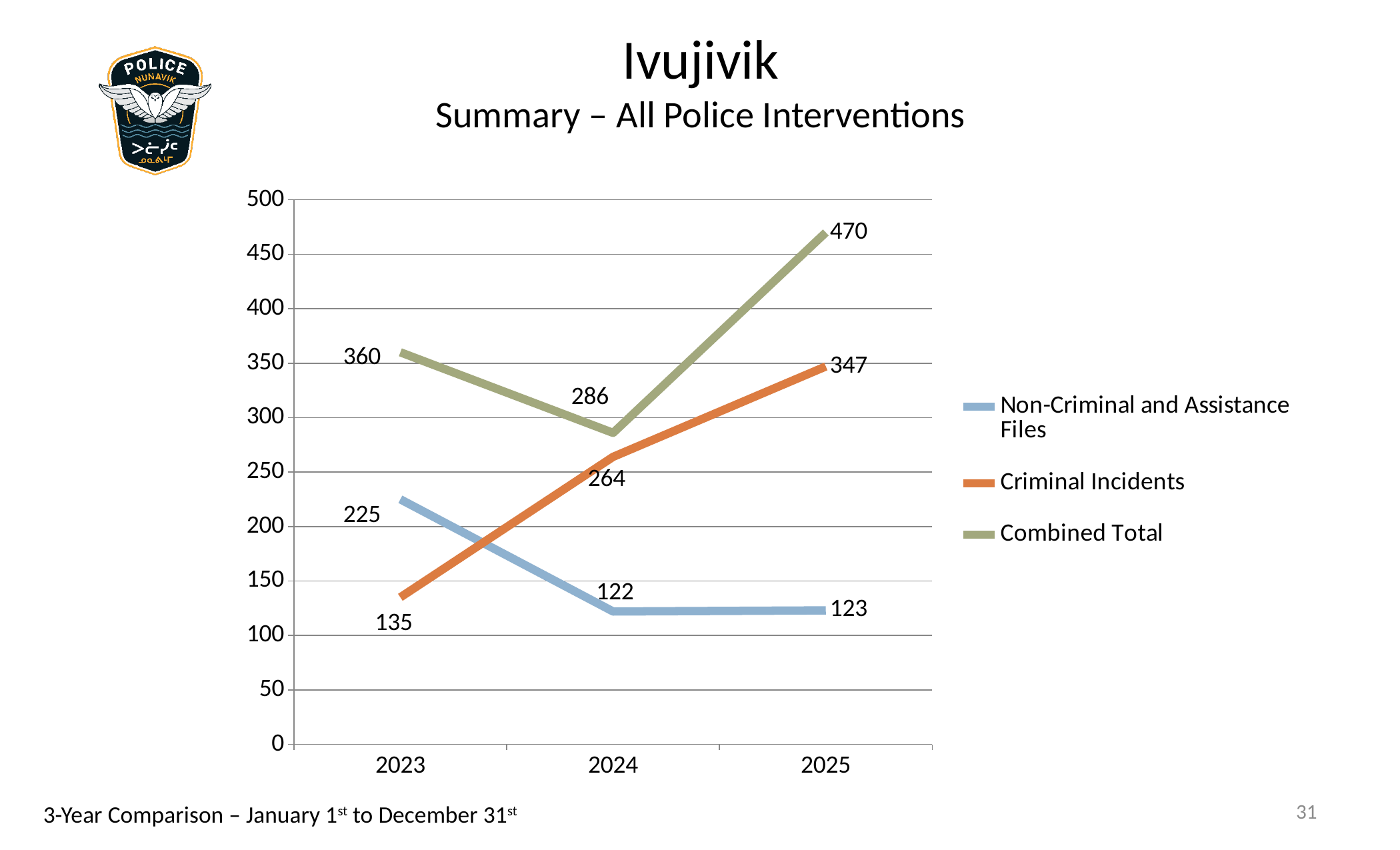
How many years are shown on the x axis? 3 Does the Criminal Incidents line rise or fall from 2023 to 2025? Rises How many series does the legend list? 3 In which year is the Combined Total highest? 2025 What is the difference between Criminal Incidents and Non-Criminal and Assistance Files in 2024? 142 What is the value for Criminal Incidents in 2025? 347 Which is larger in 2023: Non-Criminal and Assistance Files or Criminal Incidents? Non-Criminal and Assistance Files What is the Combined Total for 2024? 286 What is the value for Non-Criminal and Assistance Files in 2023? 225 What kind of chart is shown on the slide? Line chart What is the difference between the Combined Total in 2025 and in 2023? 110 In which year is the Criminal Incidents value lowest? 2023